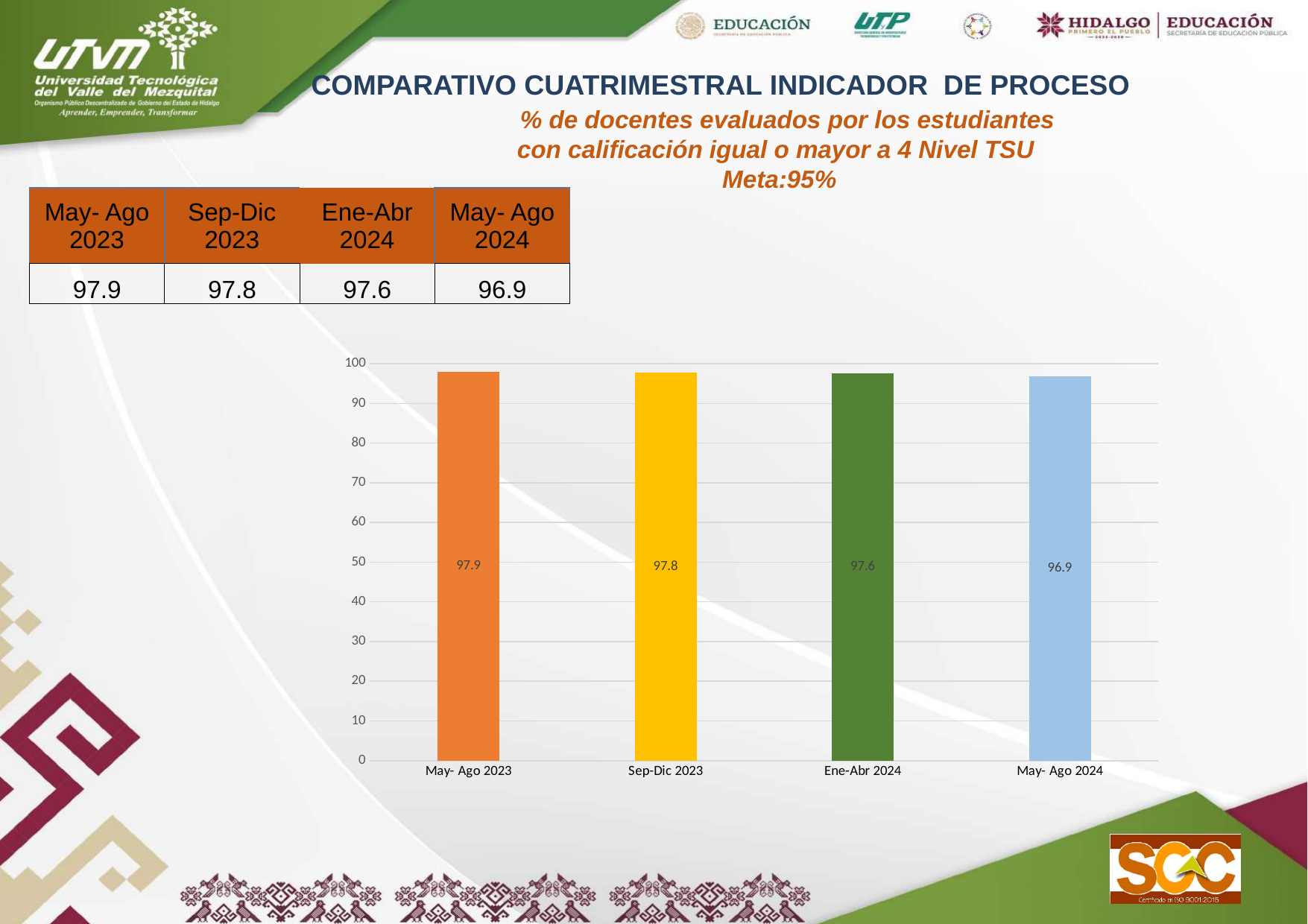
Is the value for Ene-Abr 2024 greater or less than 90? greater What is the value for Sep-Dic 2023? 97.8 How many periods are shown on the chart? 4 What is the value for May- Ago 2024? 96.9 Do the values rise or fall from May- Ago 2023 to May- Ago 2024? Fall Which period has the lowest value? May- Ago 2024 What is the value for Ene-Abr 2024? 97.6 What is the value for May- Ago 2023? 97.9 What kind of chart is shown? Bar chart Which period has the highest value? May- Ago 2023 What is the difference between the values for Sep-Dic 2023 and Ene-Abr 2024? 0.2 What is the difference between the values for May- Ago 2023 and May- Ago 2024? 1.0